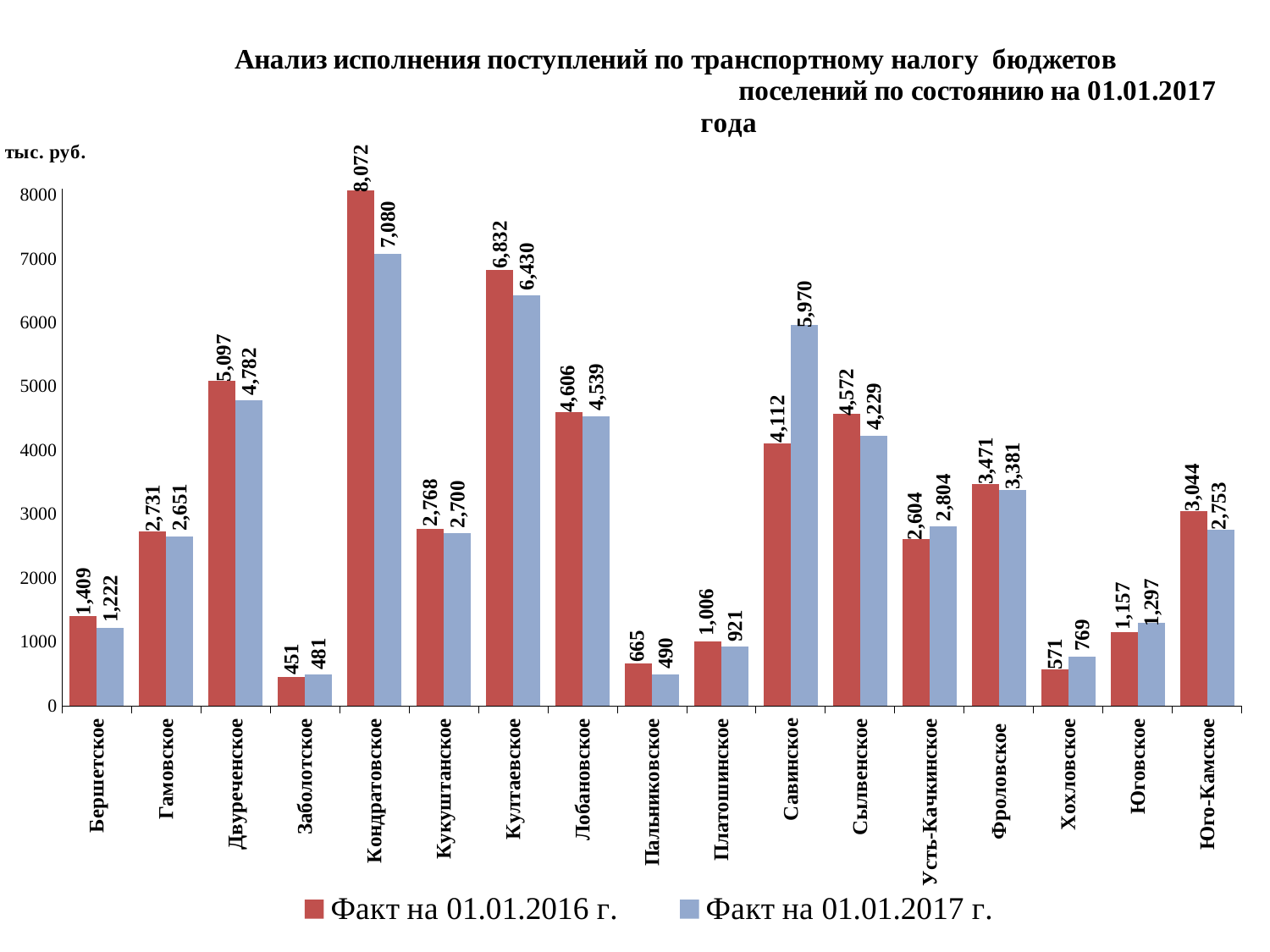
What is the value for Савинское in the series "Факт на 01.01.2017 г."? 5,970 What is the difference between the 2017 and 2016 values for Савинское? 1,858 What is the value for Хохловское in the series "Факт на 01.01.2016 г."? 571 Is the value for Култаевское in the series "Факт на 01.01.2017 г." greater or less than 6000? greater Which category has the highest value in the series "Факт на 01.01.2017 г."? Кондратовское What kind of chart is shown on the slide? Bar chart How many series does the legend list? 2 What is the value for Кондратовское in the series "Факт на 01.01.2016 г."? 8,072 Which category has the lowest value in the series "Факт на 01.01.2016 г."? Заболотское How many categories (settlements) are shown on the x axis? 17 For Усть-Качкинское, which is larger: the value for "Факт на 01.01.2016 г." or "Факт на 01.01.2017 г."? Факт на 01.01.2017 г. What is the difference between the 2016 and 2017 values for Кондратовское? 992